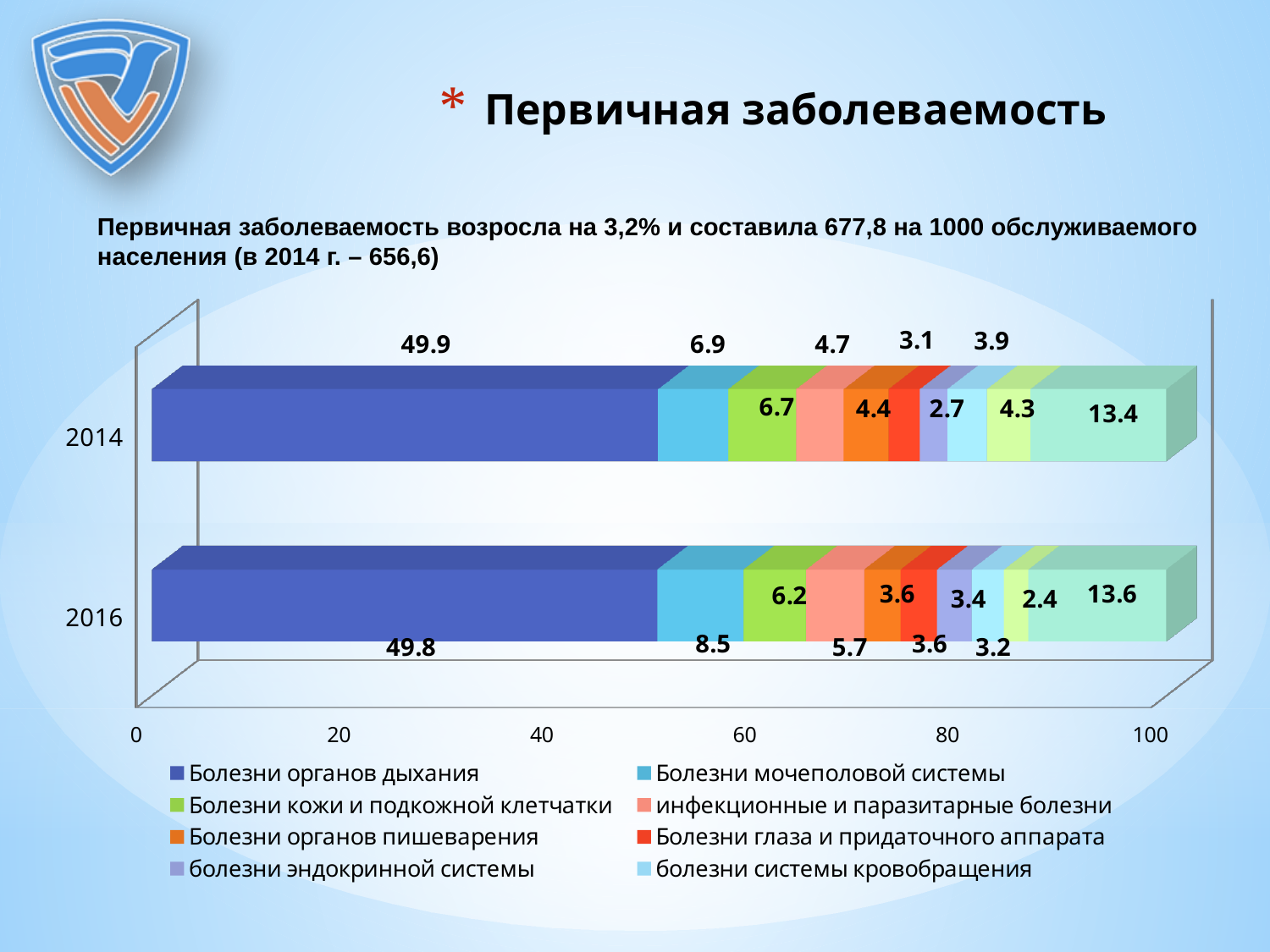
How many years (categories) are plotted on the chart? 2 By how much did the value for Болезни мочеполовой системы change from 2014 to 2016? 1.6 What is the value for болезни эндокринной системы in 2016? 3.4 Which year has the larger value for Болезни кожи и подкожной клетчатки, 2014 or 2016? 2014 What is the value for Болезни органов дыхания in 2014? 49.9 What is the value for Болезни мочеполовой системы in 2016? 8.5 What is the value for инфекционные и паразитарные болезни in 2016? 5.7 What type of chart is shown on the slide? Stacked bar chart What is the value for Болезни кожи и подкожной клетчатки in 2014? 6.7 How many series does the chart legend list? 8 Which series has the largest segment in the 2016 bar? Болезни органов дыхания What is the value for Болезни органов пишеварения in 2014? 4.4